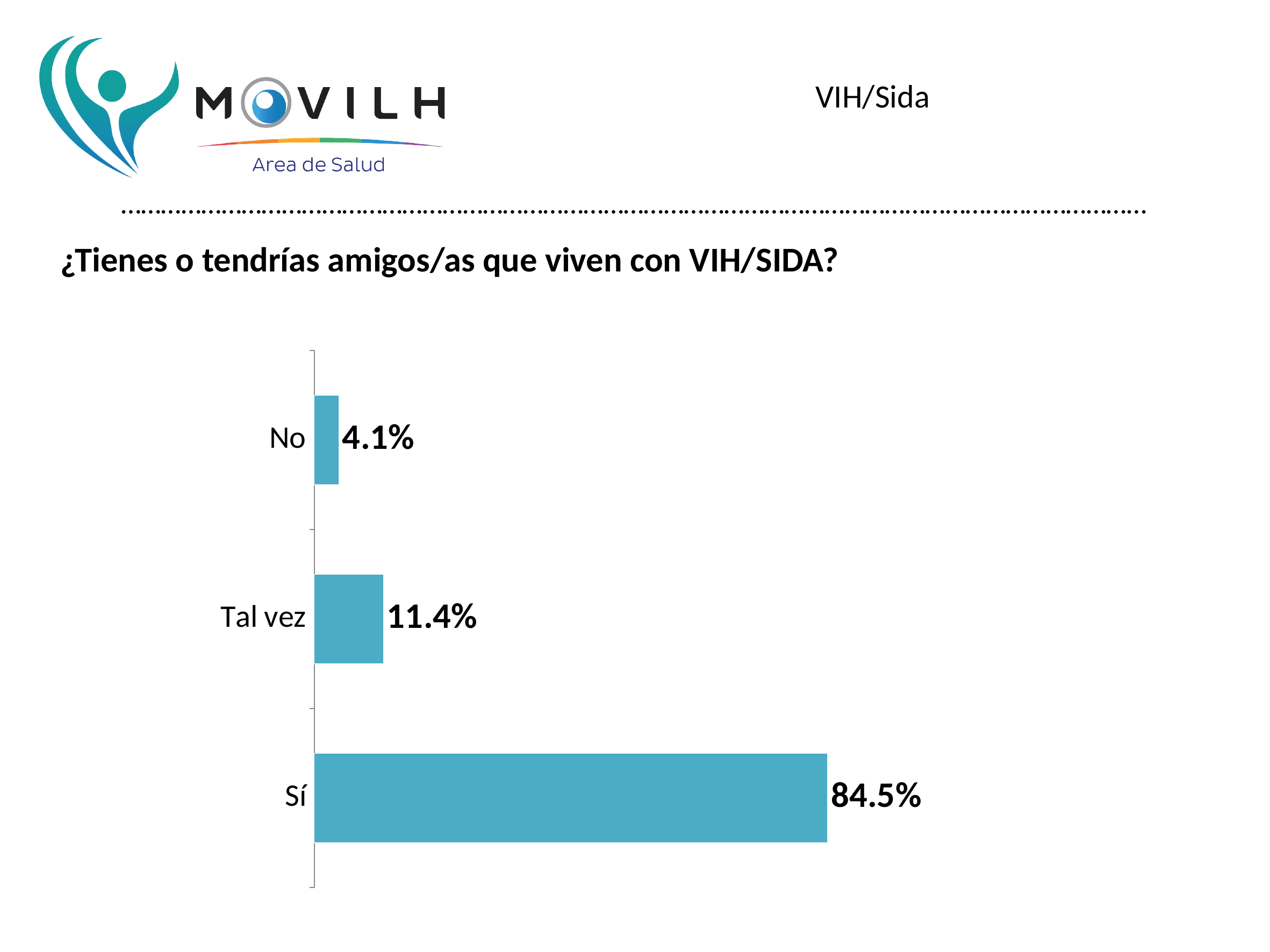
What is the difference between the values for "Tal vez" and "No"? 7.3% What question does the chart title ask? ¿Tienes o tendrías amigos/as que viven con VIH/SIDA? What kind of chart is shown on the slide? Bar chart Which category has the highest value? Sí Which category has the lowest value? No What colour are the bars in the chart? Teal blue How many categories are shown in the chart? 3 What is the difference between the values for "Sí" and "Tal vez"? 73.1% Which is larger, the value for "Tal vez" or the value for "No"? Tal vez What is the value for "Sí"? 84.5% What is the value for "No"? 4.1% What is the value for "Tal vez"? 11.4%